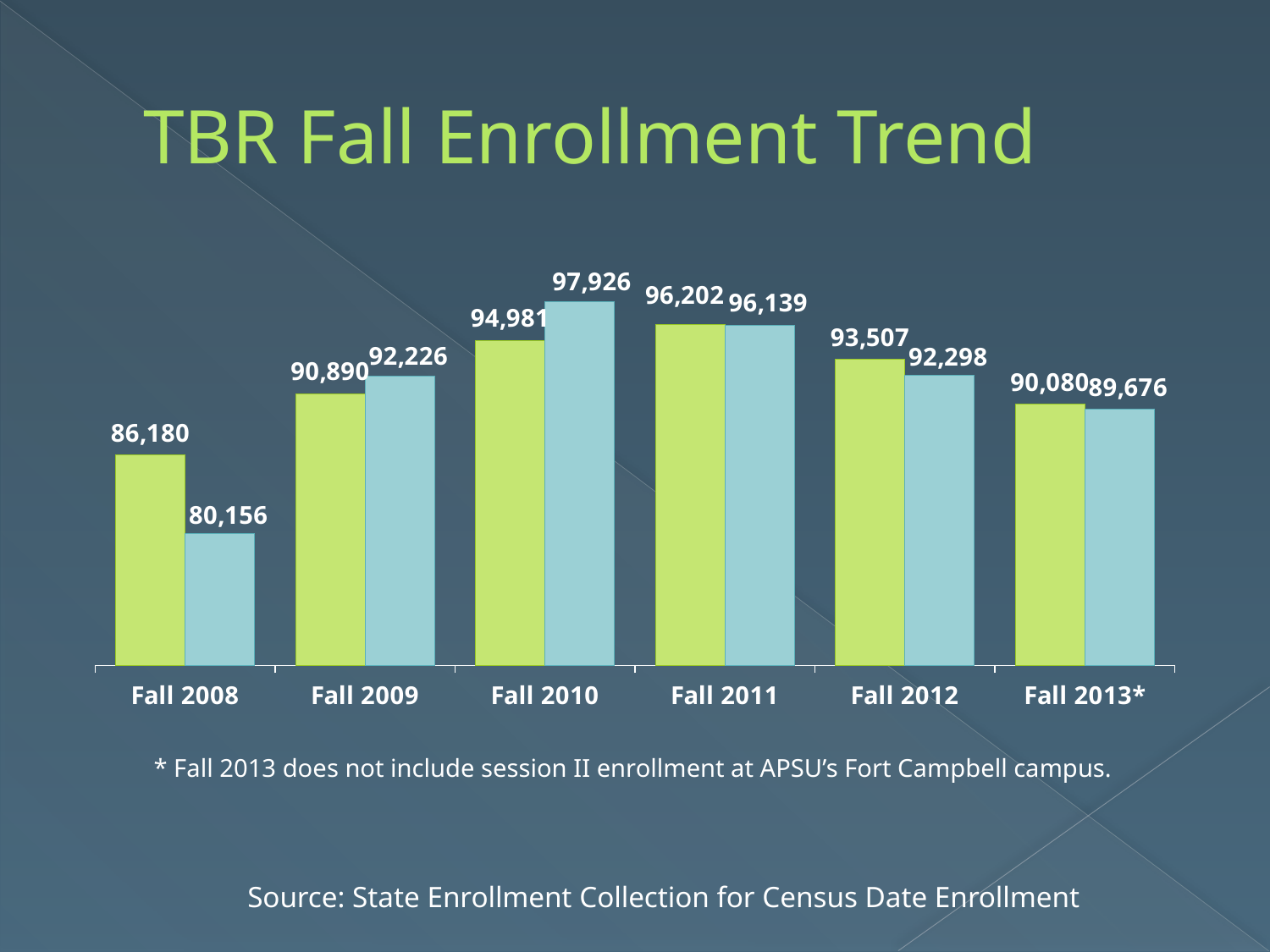
What is the difference between the green and blue bars for Fall 2008? 6,024 Which is larger for Fall 2009, the green bar or the blue bar? the blue bar Which category has the lowest blue bar? Fall 2008 What is the value of the blue bar for Fall 2013*? 89,676 What is the value of the green bar for Fall 2012? 93,507 What is the title of the chart? TBR Fall Enrollment Trend What is the value of the blue bar for Fall 2010? 97,926 What is the value of the green bar for Fall 2008? 86,180 Which category has the highest green bar? Fall 2011 What kind of chart is shown on the slide? bar chart Do the green bar values rise or fall from Fall 2011 to Fall 2013*? fall How many categories are shown on the x axis? 6